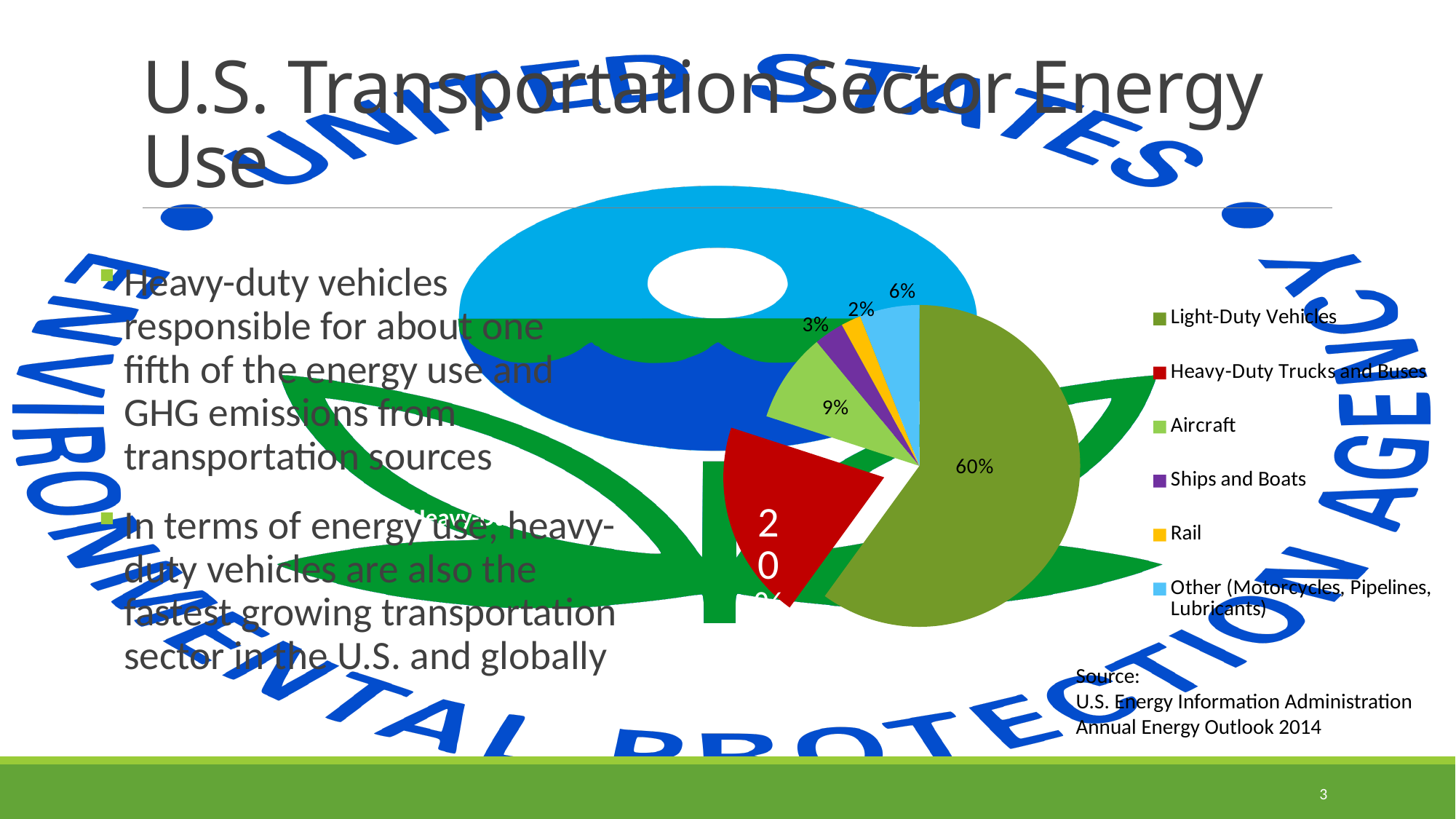
What share of the pie is Ships and Boats? 3% What share of the pie is Rail? 2% Which category has the smallest share of the pie? Rail What share of the pie is Aircraft? 9% How many categories does the legend list? 6 What is the difference in percentage points between the Aircraft share and the Ships and Boats share? 6 What kind of chart is shown on the slide? pie chart What colour represents Heavy-Duty Trucks and Buses in the pie chart? red What share of the pie is Other (Motorcycles, Pipelines, Lubricants)? 6% Which has a larger share, Aircraft or Other (Motorcycles, Pipelines, Lubricants)? Aircraft Which category has the largest share of the pie? Light-Duty Vehicles What share of U.S. transportation sector energy use is attributed to Light-Duty Vehicles? 60%